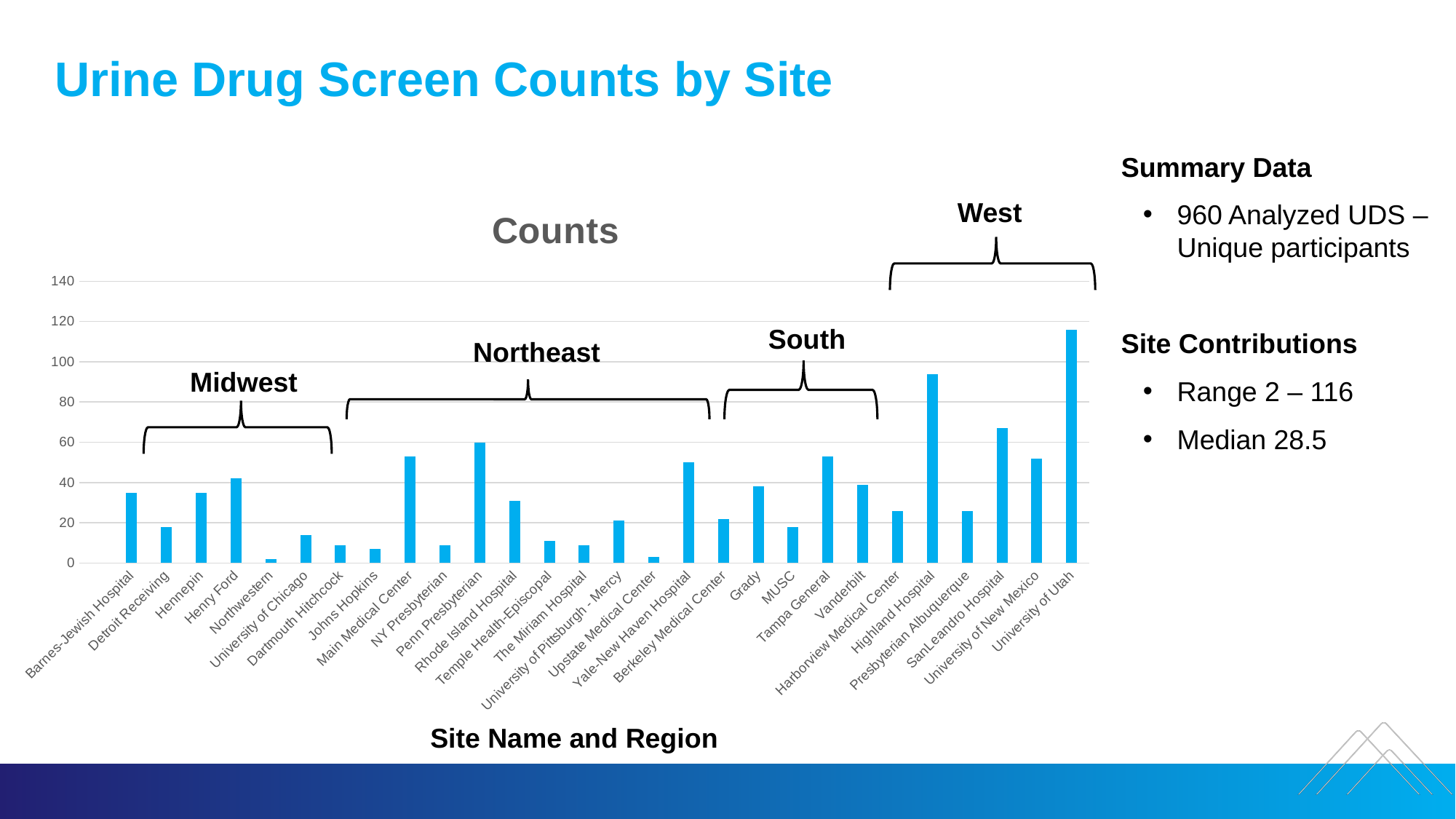
Is the value for Northwestern greater or less than 20? less What is the title of the chart? Counts What kind of chart is shown on the slide? bar chart What is the x-axis title of the chart? Site Name and Region Is the value for Upstate Medical Center greater or less than 20? less Which site has the lowest count in the chart? Northwestern Is the value for University of Utah greater or less than 100? greater How many sites (bars) are plotted in the chart? 28 Which site has a larger count, Highland Hospital or SanLeandro Hospital? Highland Hospital Which site has the highest count in the chart? University of Utah Which site has a larger count, Tampa General or MUSC? Tampa General